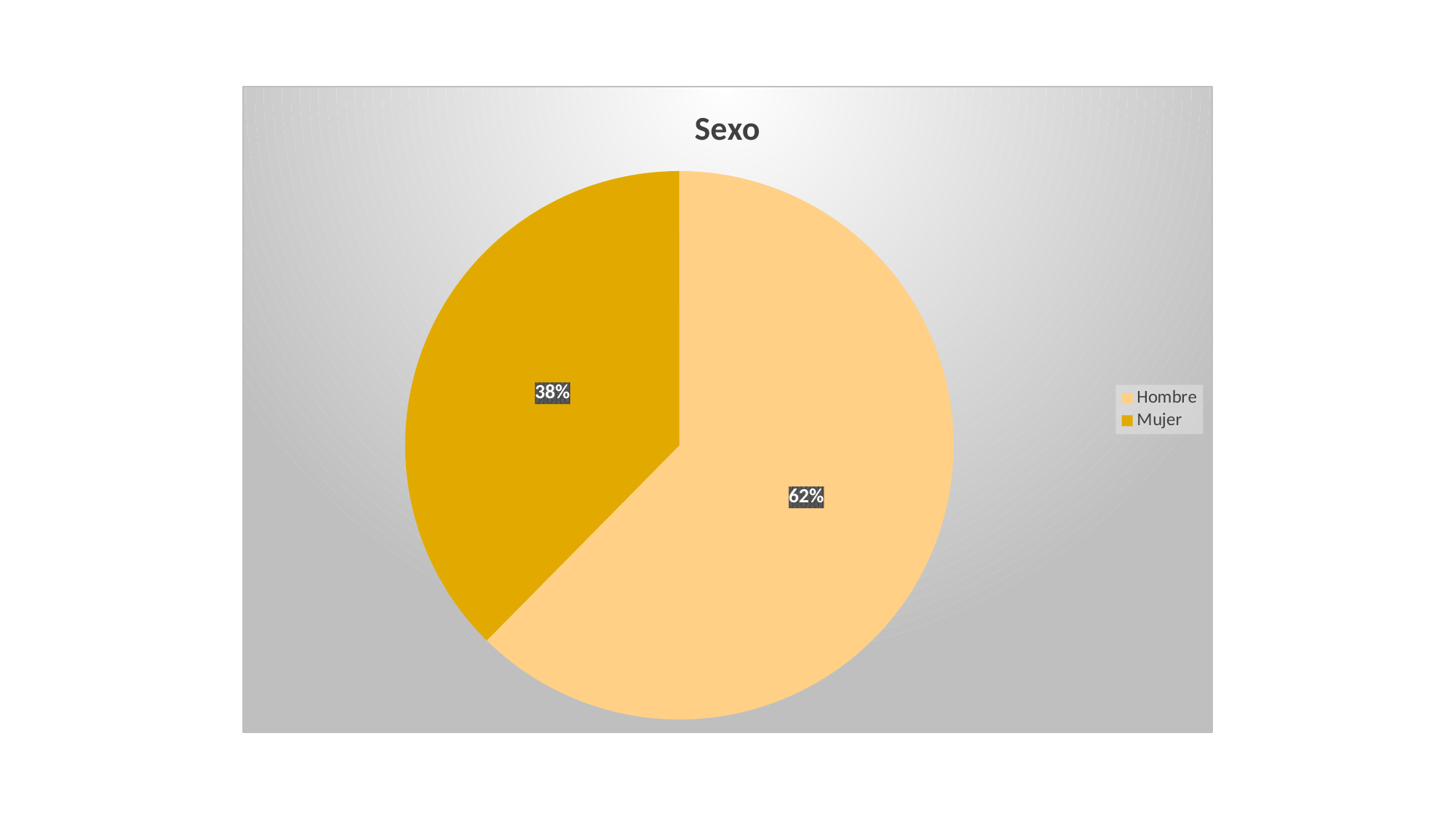
Which category has the largest share of the pie? Hombre How many categories does the pie chart have? 2 How many entries does the legend list? 2 Which category has the smallest share of the pie? Mujer What type of chart is shown on the slide? pie chart Is the share for Mujer greater or less than 50%? less What percentage of the pie is Mujer? 38% What is the difference in percentage points between Hombre and Mujer? 24 Which legend entry is shown in the darker gold colour? Mujer Which is larger, the share for Hombre or the share for Mujer? Hombre What percentage of the pie is Hombre? 62% What is the title of the chart? Sexo